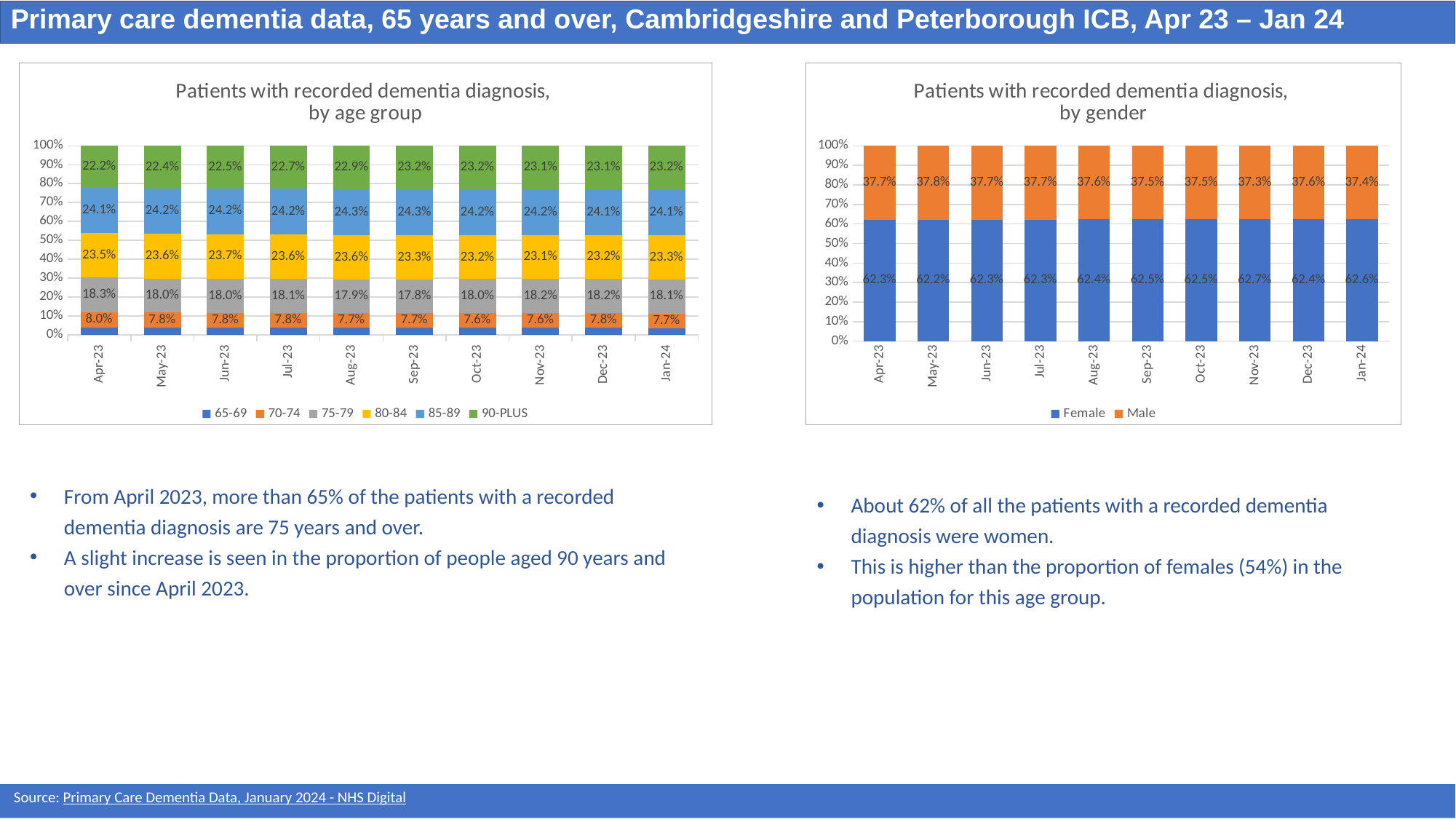
What kind of chart is the 'Patients with recorded dementia diagnosis, by gender' chart? stacked bar chart In the 'Patients with recorded dementia diagnosis, by gender' chart, which month has the highest Female value? Nov-23 In the 'Patients with recorded dementia diagnosis, by gender' chart, what is the difference between the Female and Male values in Jan-24? 25.2% In the 'Patients with recorded dementia diagnosis, by age group' chart, what is the value for the 70-74 group in Jan-24? 7.7% In the 'Patients with recorded dementia diagnosis, by age group' chart, what is the value for the 90-PLUS group in Apr-23? 22.2% In the 'Patients with recorded dementia diagnosis, by age group' chart, what is the value for the 75-79 group in Sep-23? 17.8% In the 'Patients with recorded dementia diagnosis, by age group' chart, how many series does the legend list? 6 In the 'Patients with recorded dementia diagnosis, by age group' chart, how many months are shown on the x axis? 10 In the 'Patients with recorded dementia diagnosis, by gender' chart, what is the Female value for Nov-23? 62.7% In the 'Patients with recorded dementia diagnosis, by age group' chart, does the 90-PLUS share rise or fall from Apr-23 to Jan-24? rise In the 'Patients with recorded dementia diagnosis, by age group' chart, what is the difference between the 85-89 and 80-84 values in Nov-23? 1.1% In the 'Patients with recorded dementia diagnosis, by gender' chart, what is the Male value for May-23? 37.8%